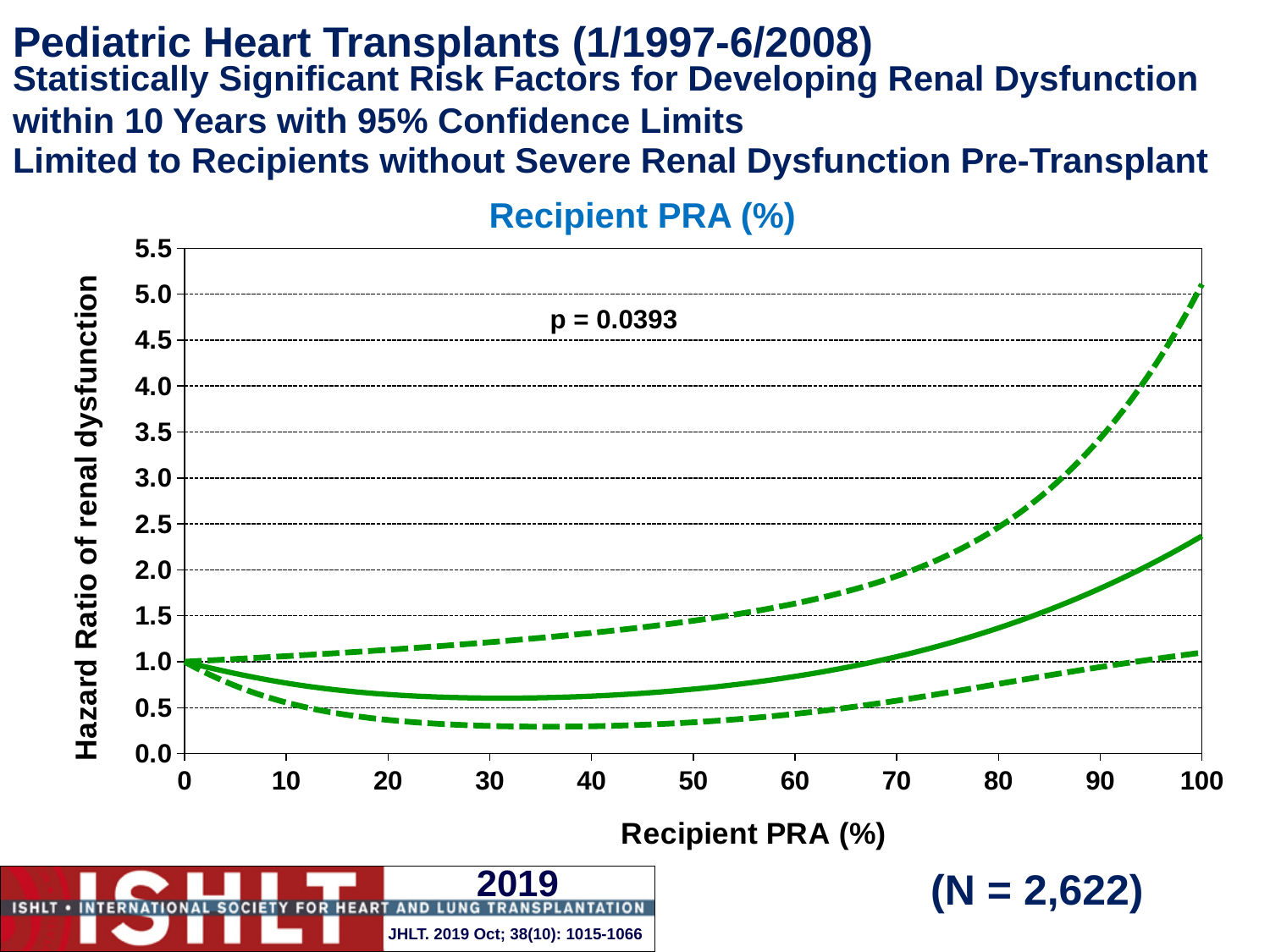
How many lines are plotted on the chart? 3 Is the hazard ratio of the solid line at a Recipient PRA of 30% greater or less than 1.0? less What is the sample size (N) shown on the slide? N = 2,622 What is the title of the chart? Recipient PRA (%) Is the lower dashed confidence limit at a Recipient PRA of 40% greater or less than 0.5? less What p-value is printed on the chart? p = 0.0393 Does the solid hazard ratio line rise or fall as Recipient PRA increases from 40% to 100%? rise What is the label of the y axis? Hazard Ratio of renal dysfunction What is the hazard ratio of the solid line at a Recipient PRA of 0%? 1.0 Is the hazard ratio of the solid line at a Recipient PRA of 100% greater or less than 2.0? greater What kind of chart is shown on the slide? line chart